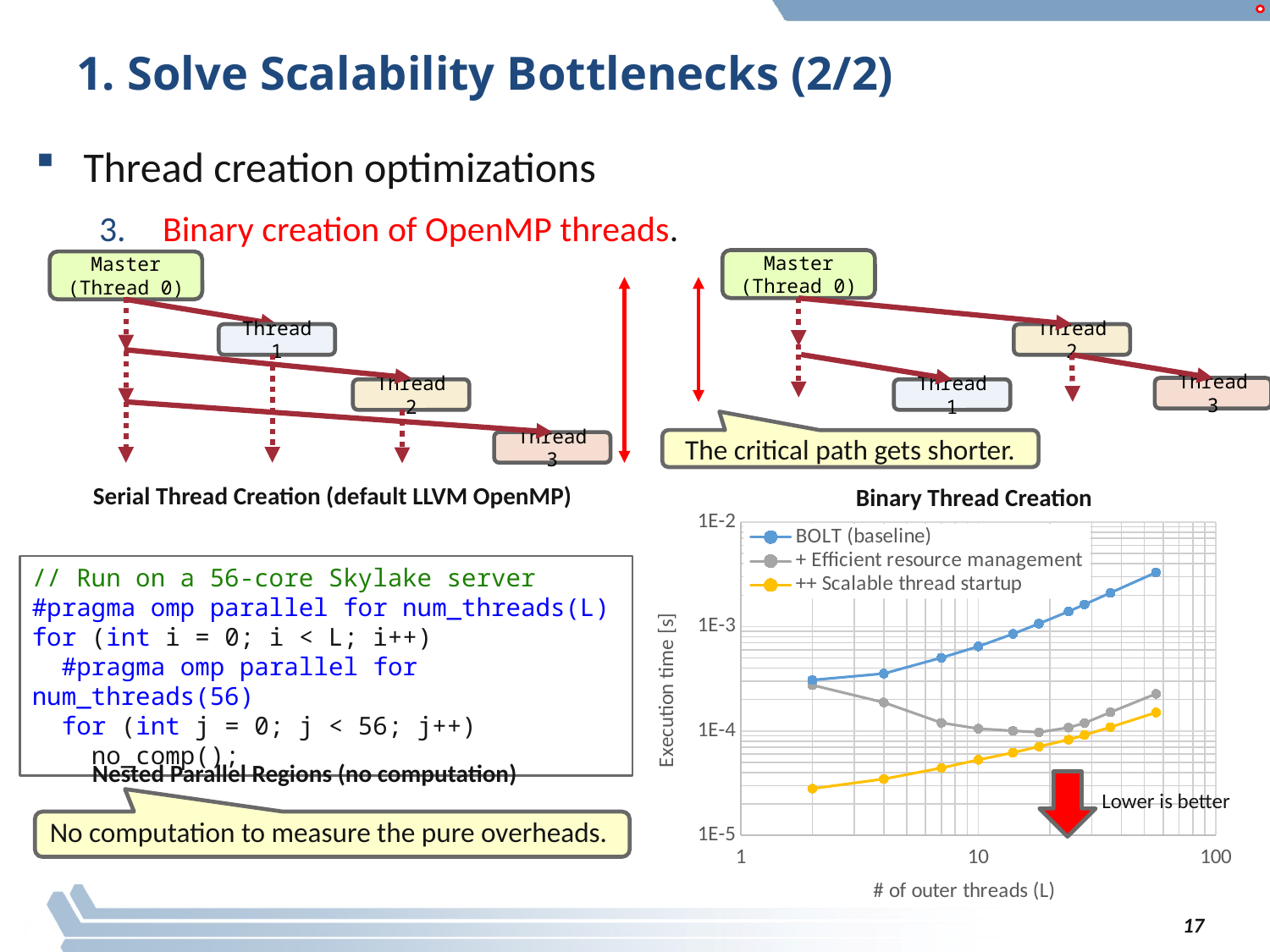
Does the execution time for the ++ Scalable thread startup series rise or fall as the number of outer threads increases? rise Is the execution time for ++ Scalable thread startup at the smallest number of outer threads greater or less than 1E-4? less At the smallest number of outer threads plotted, which series has the larger execution time: BOLT (baseline) or ++ Scalable thread startup? BOLT (baseline) How many series does the chart's legend list? 3 Which series has the highest execution time at the largest number of outer threads plotted? BOLT (baseline) Is the execution time for + Efficient resource management at the smallest number of outer threads greater or less than 1E-4? greater What kind of chart is shown on the slide? line chart What is the label of the y axis of the chart? Execution time [s] Is the execution time for BOLT (baseline) at the largest number of outer threads greater or less than 1E-3? greater Does the execution time for the BOLT (baseline) series rise or fall as the number of outer threads increases? rise What is the label of the x axis of the chart? # of outer threads (L) Which series has the lowest execution time across the plotted range of outer threads? ++ Scalable thread startup